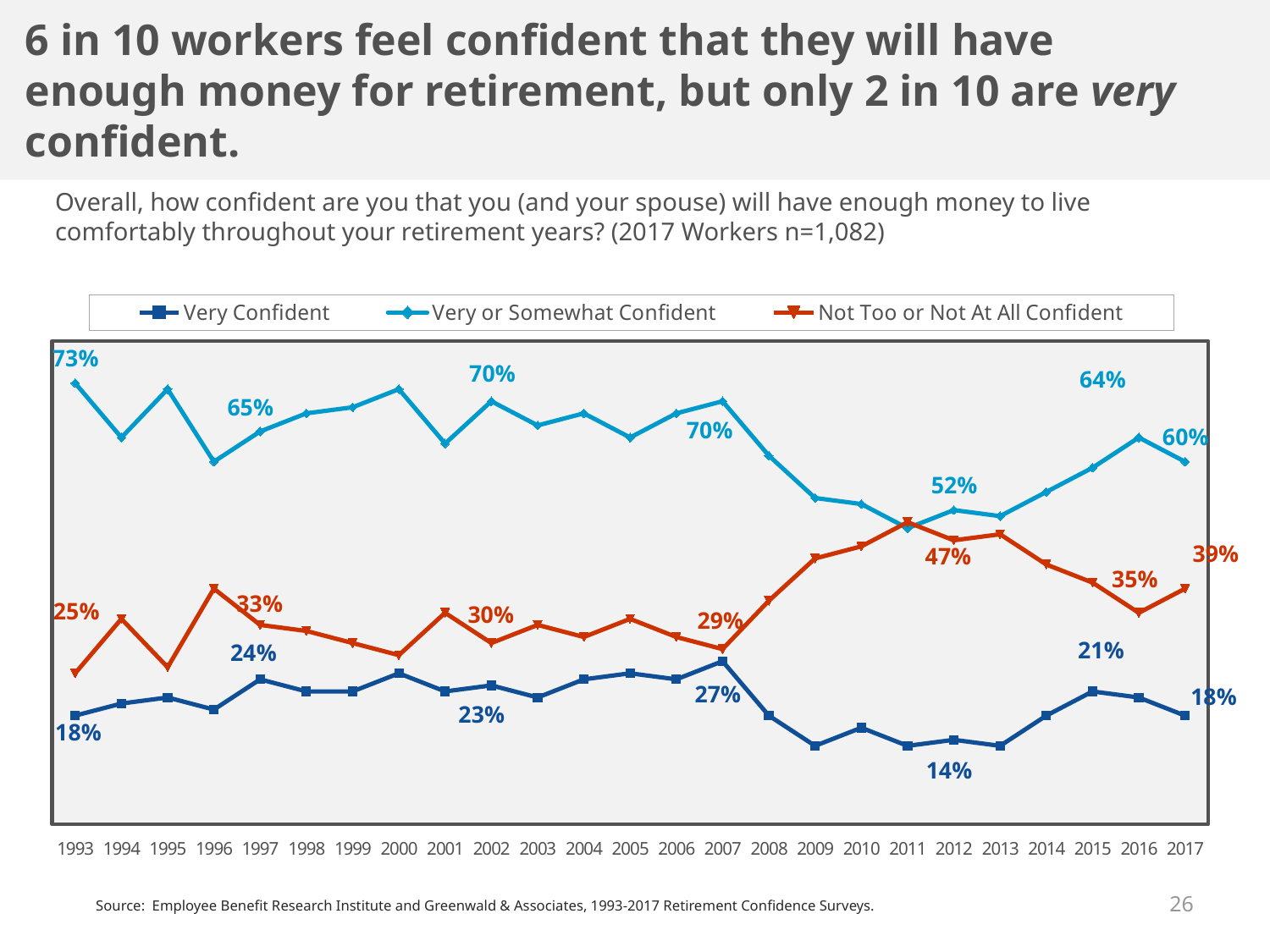
How many series does the legend list? 3 In 2017, what is the difference between the Very or Somewhat Confident value and the Not Too or Not At All Confident value? 21 percentage points What percentage of workers were Very or Somewhat Confident in 1993? 73% In which year does the Not Too or Not At All Confident line reach its highest value? 2011 In 1993, what is the difference between the Very or Somewhat Confident value and the Very Confident value? 55 percentage points What kind of chart is shown on the slide? Line chart How many years are shown on the x axis? 25 Which year has the higher Very or Somewhat Confident value, 1993 or 2017? 1993 What is the value for Very Confident in 2017? 18%